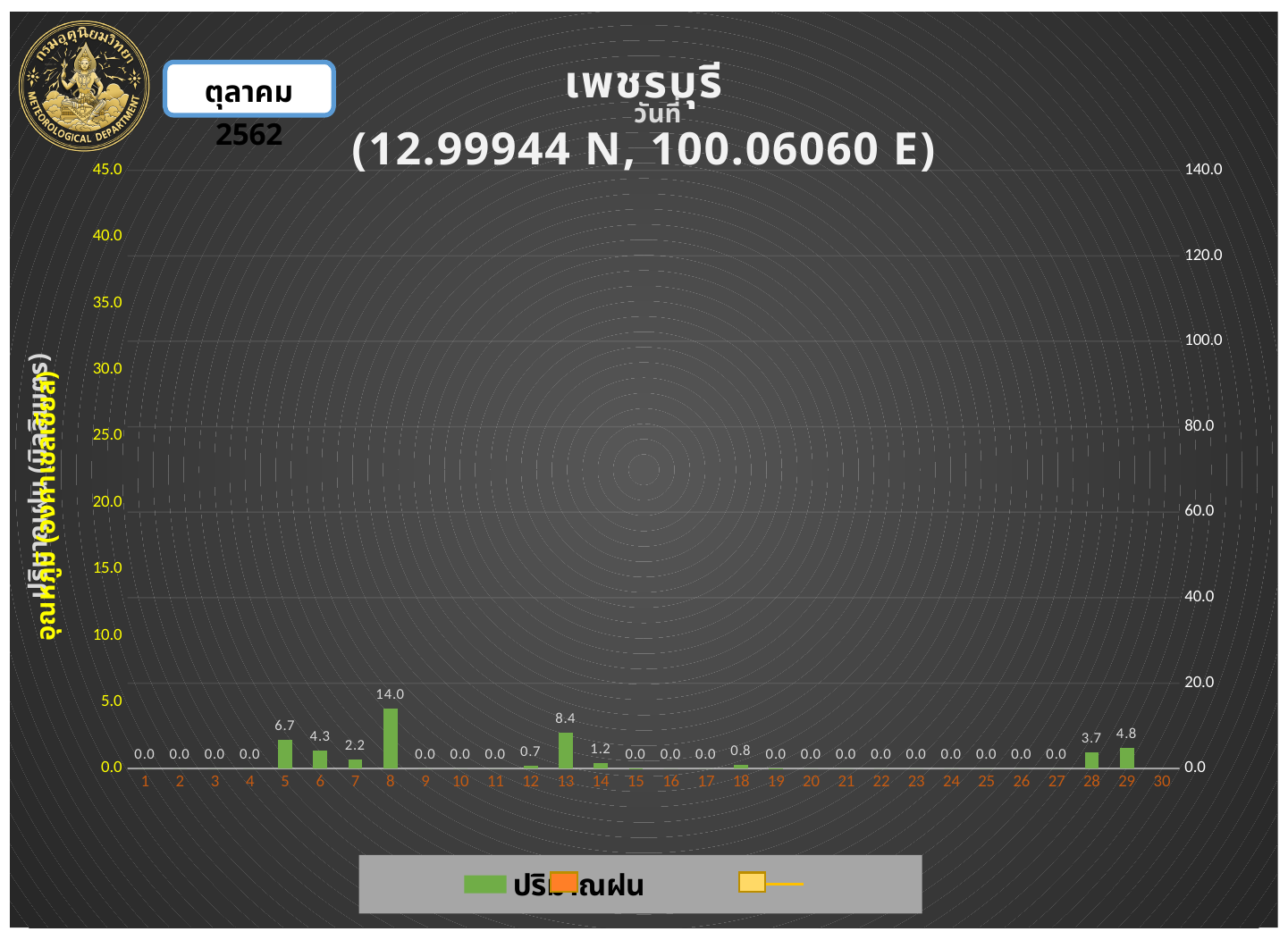
Which day has the highest rainfall value? 8 What is the rainfall value shown for day 13? 8.4 What kind of chart is used to show the rainfall values? bar chart Which has the larger rainfall value, day 6 or day 29? day 29 What is the rainfall value shown for day 8? 14.0 What is the difference between the rainfall values for day 5 and day 6? 2.4 What is the rainfall value shown for day 12? 0.7 What is the rainfall value shown for day 5? 6.7 How many days are shown on the x axis of the chart? 30 What label does the legend give for the green bars? ปริมาณฝน What is the difference between the rainfall values for day 8 and day 13? 5.6 What is the rainfall value shown for day 29? 4.8